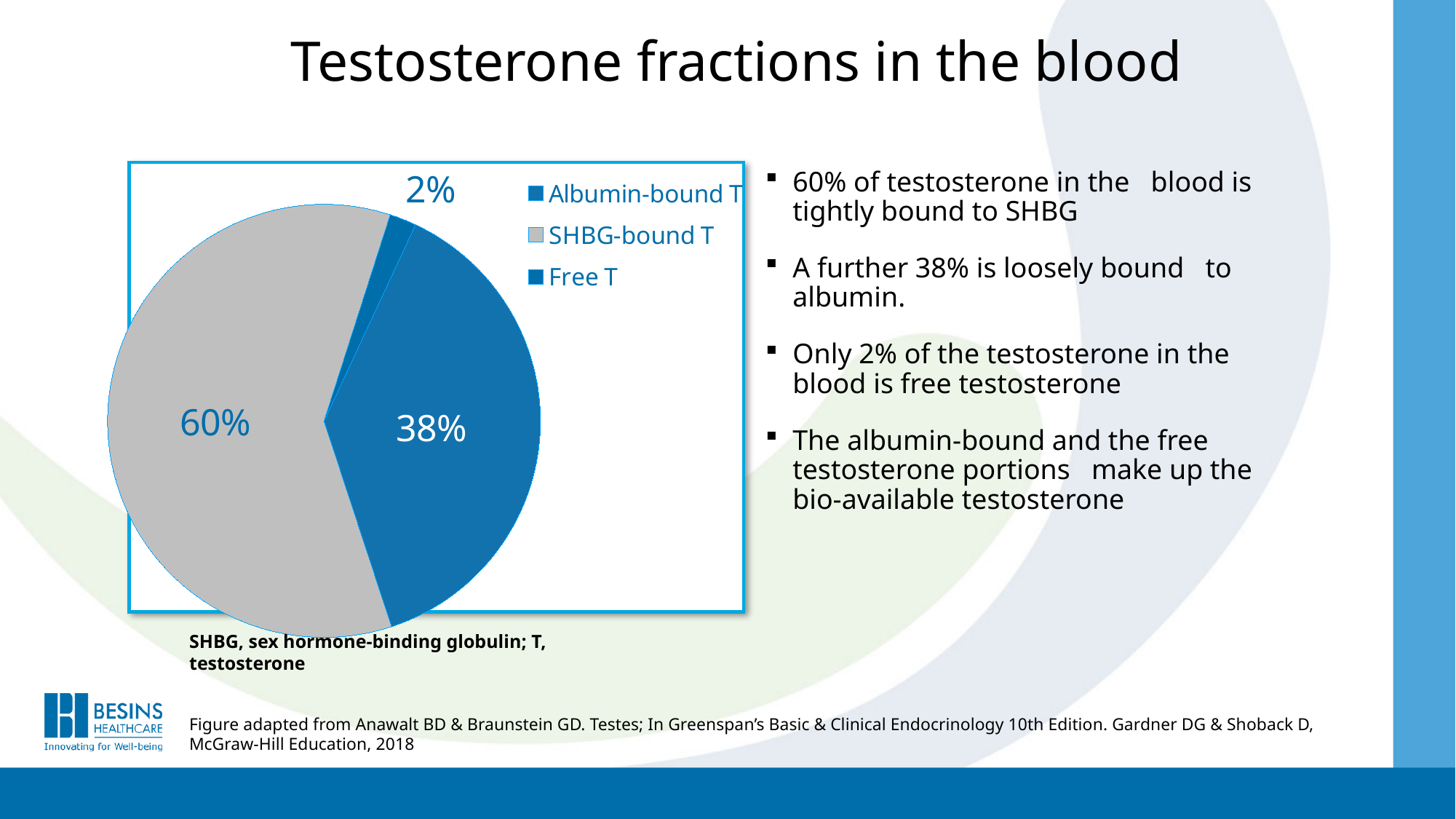
What colour is the SHBG-bound T slice in the pie chart? grey What kind of chart is shown on the slide? pie chart What percentage of testosterone is Free T according to the pie chart? 2% What percentage of testosterone is Albumin-bound T according to the pie chart? 38% What percentage of testosterone is SHBG-bound T according to the pie chart? 60% Which fraction has the smallest slice in the pie chart? Free T What is the combined share of the Albumin-bound T and Free T slices? 40% Which is larger, the Albumin-bound T slice or the Free T slice? Albumin-bound T Which fraction has the largest slice in the pie chart? SHBG-bound T How many slices does the pie chart have? 3 What is the difference in percentage points between the SHBG-bound T and Albumin-bound T slices? 22 How many entries does the legend of the pie chart list? 3